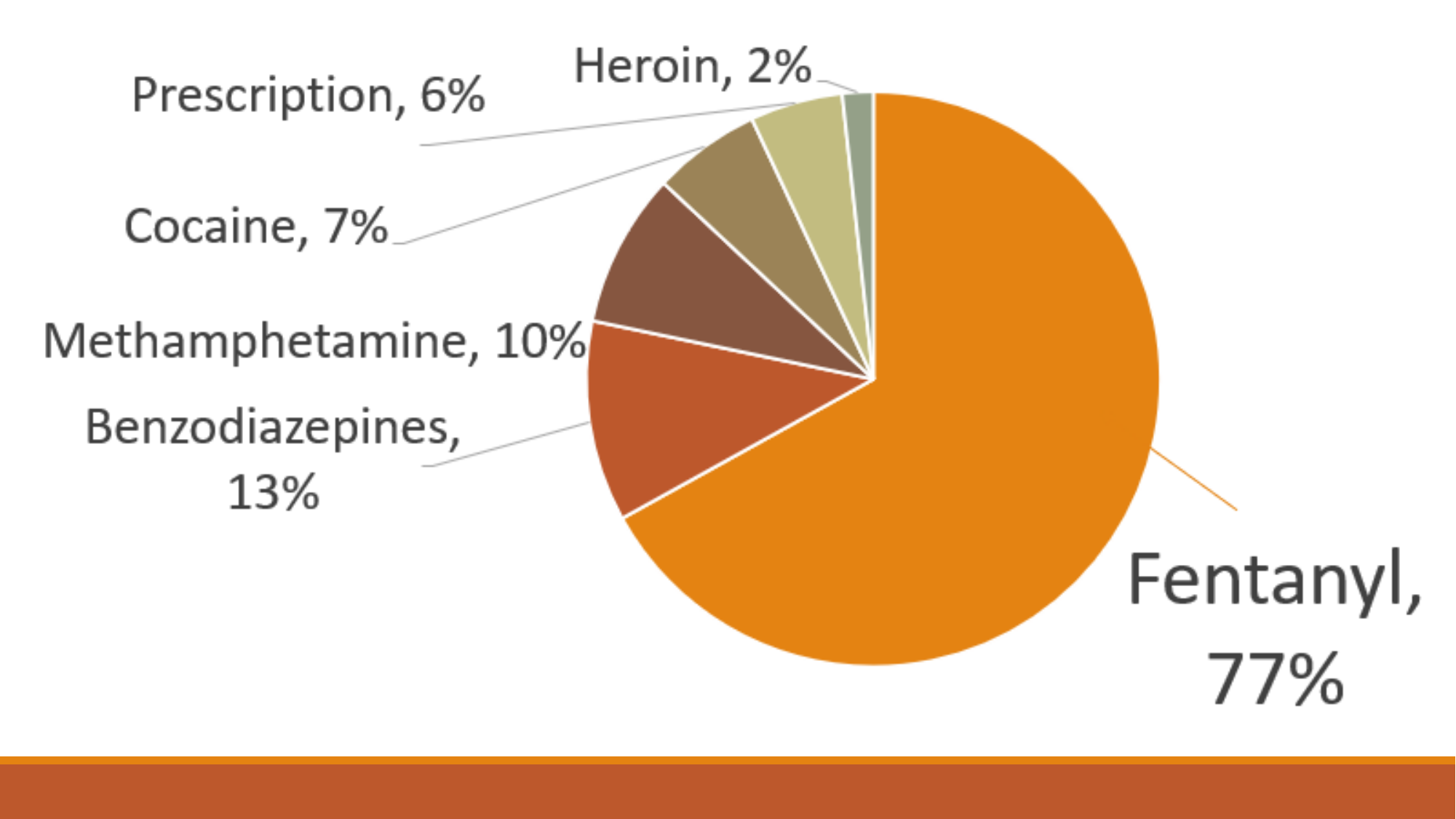
What percentage does the Benzodiazepines slice represent? 13% What is the difference between the Fentanyl share and the Benzodiazepines share? 64% How many slices does the pie chart have? 6 What percentage does the Heroin slice represent? 2% What percentage does the Methamphetamine slice represent? 10% Which category has the largest share of the pie? Fentanyl What colour is the Fentanyl slice? orange What kind of chart is shown on the slide? pie chart What percentage does the Fentanyl slice represent? 77% Which category has the smallest share of the pie? Heroin What percentage does the Cocaine slice represent? 7% Which is larger, the Cocaine share or the Prescription share? Cocaine